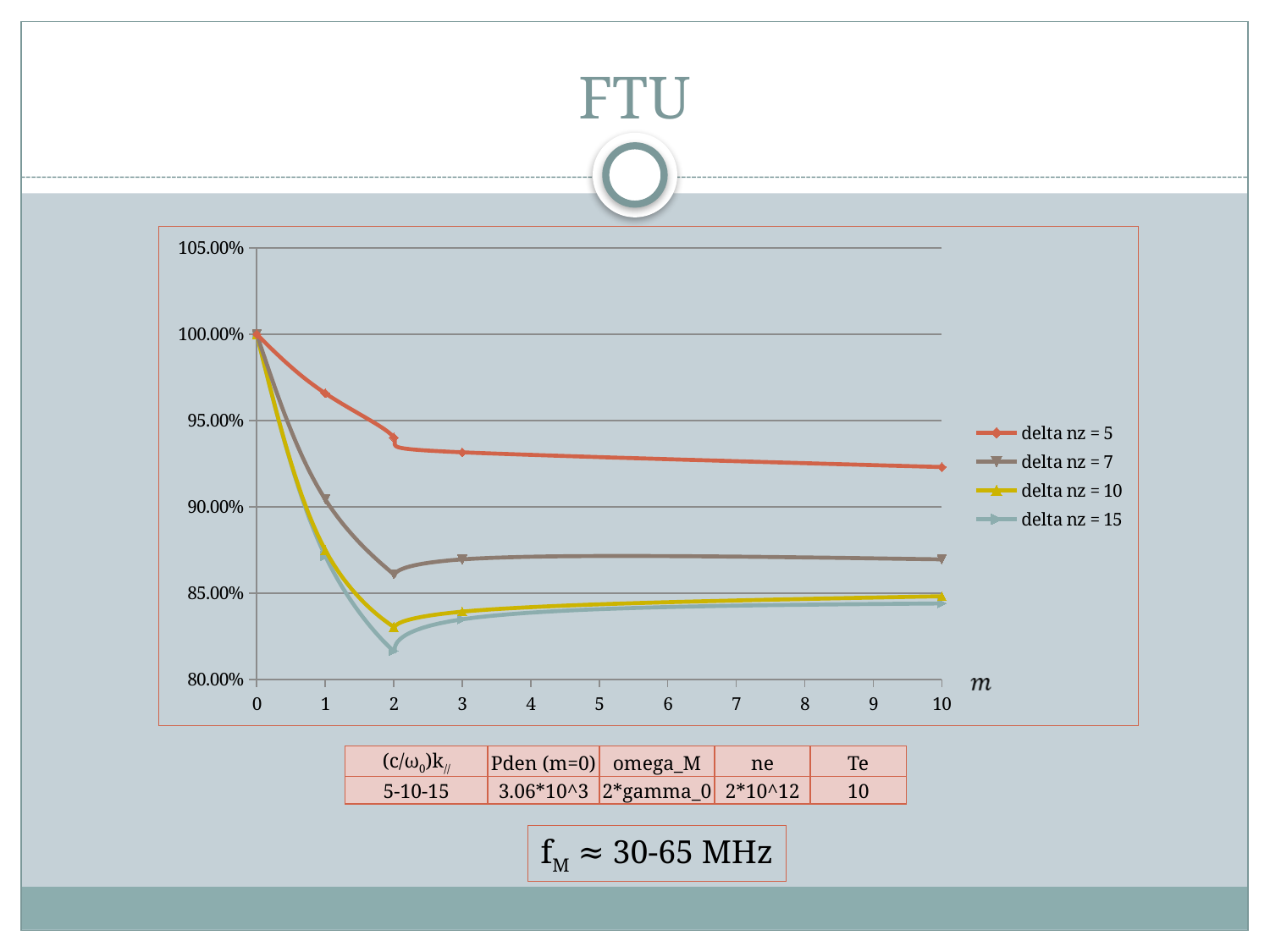
Is the value for delta nz = 15 at m = 2 greater or less than 85.00%? less What are the legend entries of the chart? delta nz = 5, delta nz = 7, delta nz = 10, delta nz = 15 Is the value for delta nz = 5 at m = 10 greater or less than 90.00%? greater How many tick labels are shown on the m axis? 11 Which series has the highest value at m = 10? delta nz = 5 Which series has the lowest value at m = 2? delta nz = 15 What kind of chart is shown on the slide? line chart At m = 2, which is larger: the value for delta nz = 5 or the value for delta nz = 10? delta nz = 5 Does the delta nz = 5 series rise or fall as m increases from 0 to 10? fall What is the value of the delta nz = 5 series at m = 0? 100.00% How many series does the legend list? 4